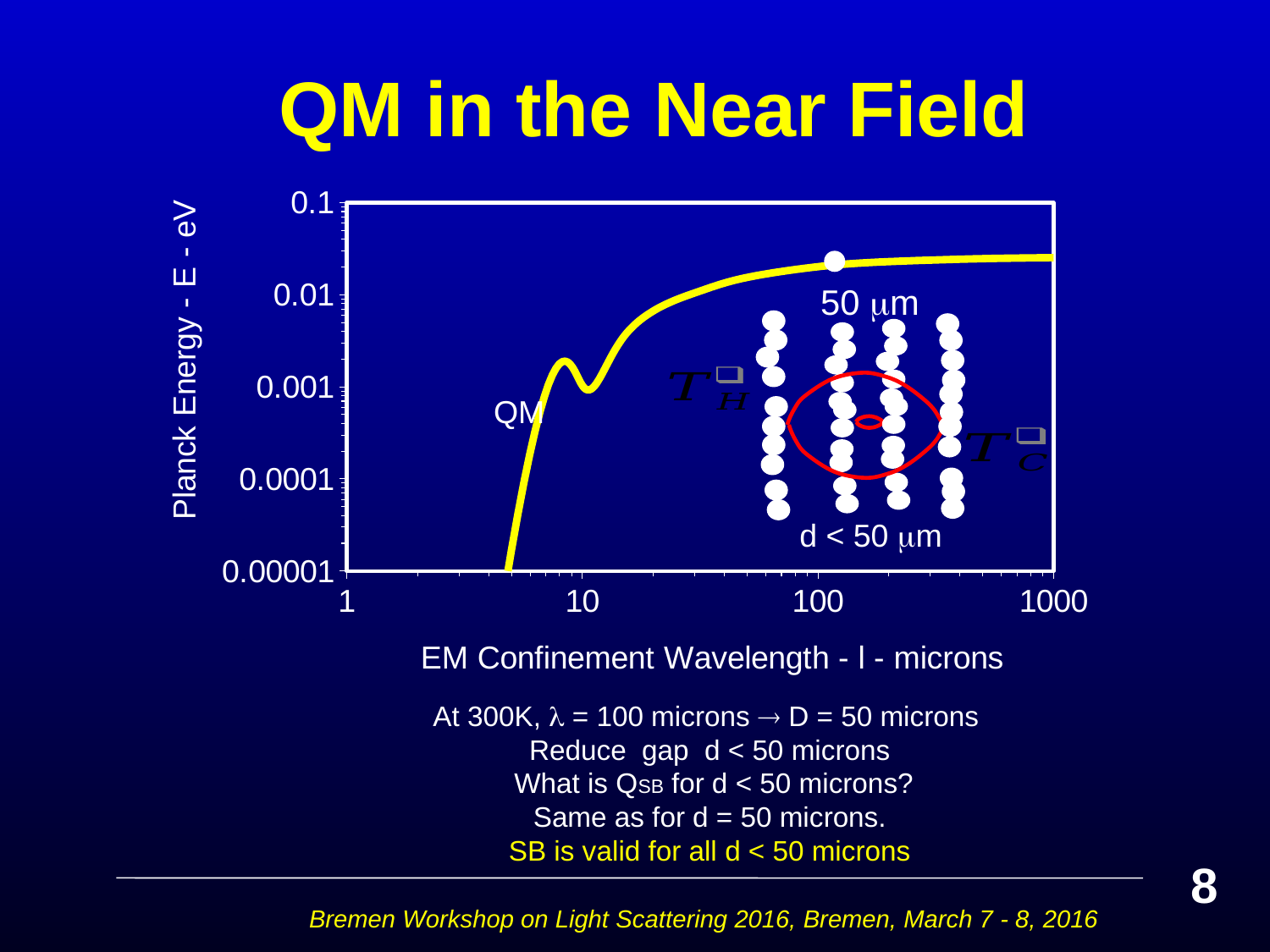
What kind of chart is shown on the slide? line chart Is the Planck energy at a wavelength of 100 microns greater or less than 0.1 eV? less Is the Planck energy at a wavelength of 1000 microns greater or less than 0.1 eV? less What is the lowest tick value shown on the y axis of the chart? 0.00001 What is the highest tick value shown on the x axis of the chart? 1000 Which has the higher Planck energy on the curve: a wavelength of 10 microns or a wavelength of 100 microns? 100 microns Does the plotted curve rise or fall as the EM confinement wavelength increases from 10 to 1000 microns? rise Is the Planck energy at a wavelength of 1000 microns greater or less than 0.01 eV? greater What is the title of the slide containing the chart? QM in the Near Field What is the label of the y axis of the chart? Planck Energy - E - eV How many curves are plotted on the chart? 1